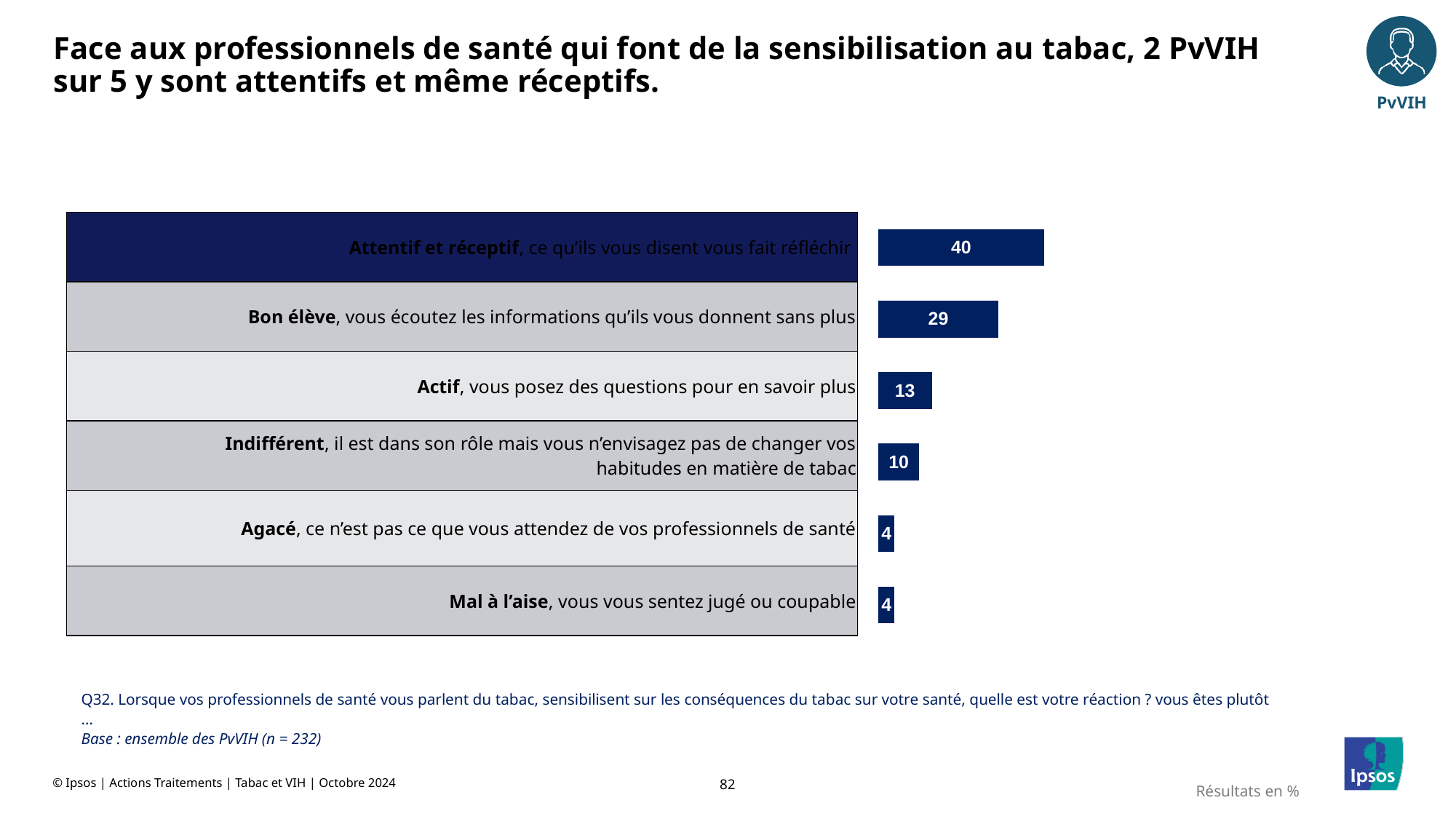
What kind of chart is shown on the slide? Bar chart Which category has the highest value? Attentif et réceptif What is the value for "Indifférent"? 10 In what unit are the results expressed, according to the note at the bottom right of the slide? % What is the difference between the values for "Bon élève" and "Actif"? 16 How many categories are shown in the chart? 6 What is the value for "Agacé"? 4 What is the value for "Attentif et réceptif"? 40 Which is larger, the value for "Actif" or the value for "Indifférent"? Actif What is the difference between the values for "Attentif et réceptif" and "Bon élève"? 11 What is the value for "Actif"? 13 What is the value for "Bon élève"? 29